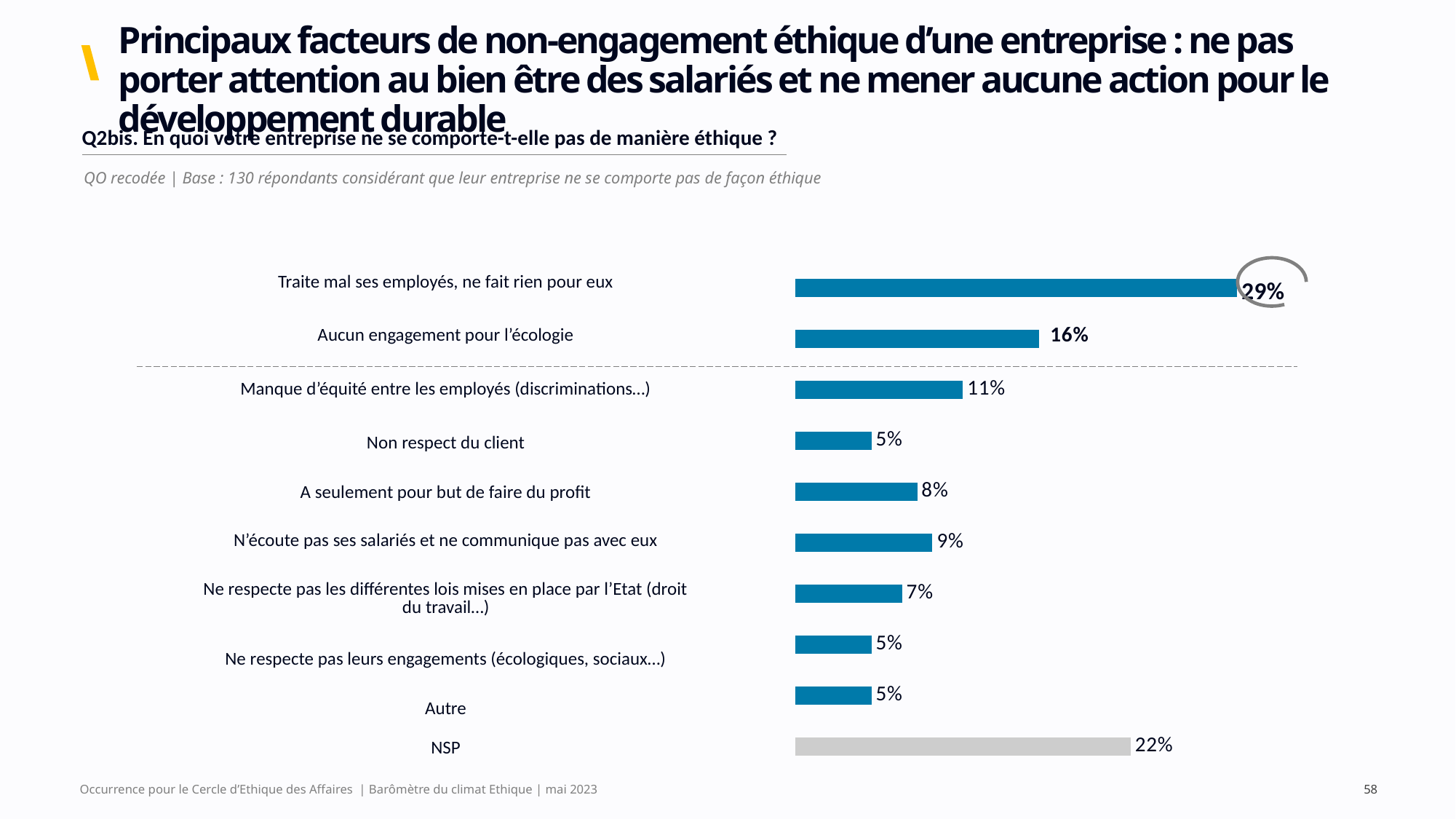
What is the difference between "Traite mal ses employés, ne fait rien pour eux" and "Aucun engagement pour l'écologie"? 13 percentage points What is the difference between "A seulement pour but de faire du profit" and "Non respect du client"? 3 percentage points What is the value for "NSP"? 22% What is the value for "N'écoute pas ses salariés et ne communique pas avec eux"? 9% What is the value for "Aucun engagement pour l'écologie"? 16% Which category has the highest value? Traite mal ses employés, ne fait rien pour eux What is the value for "Traite mal ses employés, ne fait rien pour eux"? 29% Which is larger: "N'écoute pas ses salariés et ne communique pas avec eux" or "Ne respecte pas les différentes lois mises en place par l'Etat (droit du travail…)"? N'écoute pas ses salariés et ne communique pas avec eux How many categories are shown in the chart? 10 Which bar is shown in grey rather than blue? NSP What kind of chart is shown on the slide? Bar chart What is the value for "Manque d'équité entre les employés (discriminations…)"? 11%